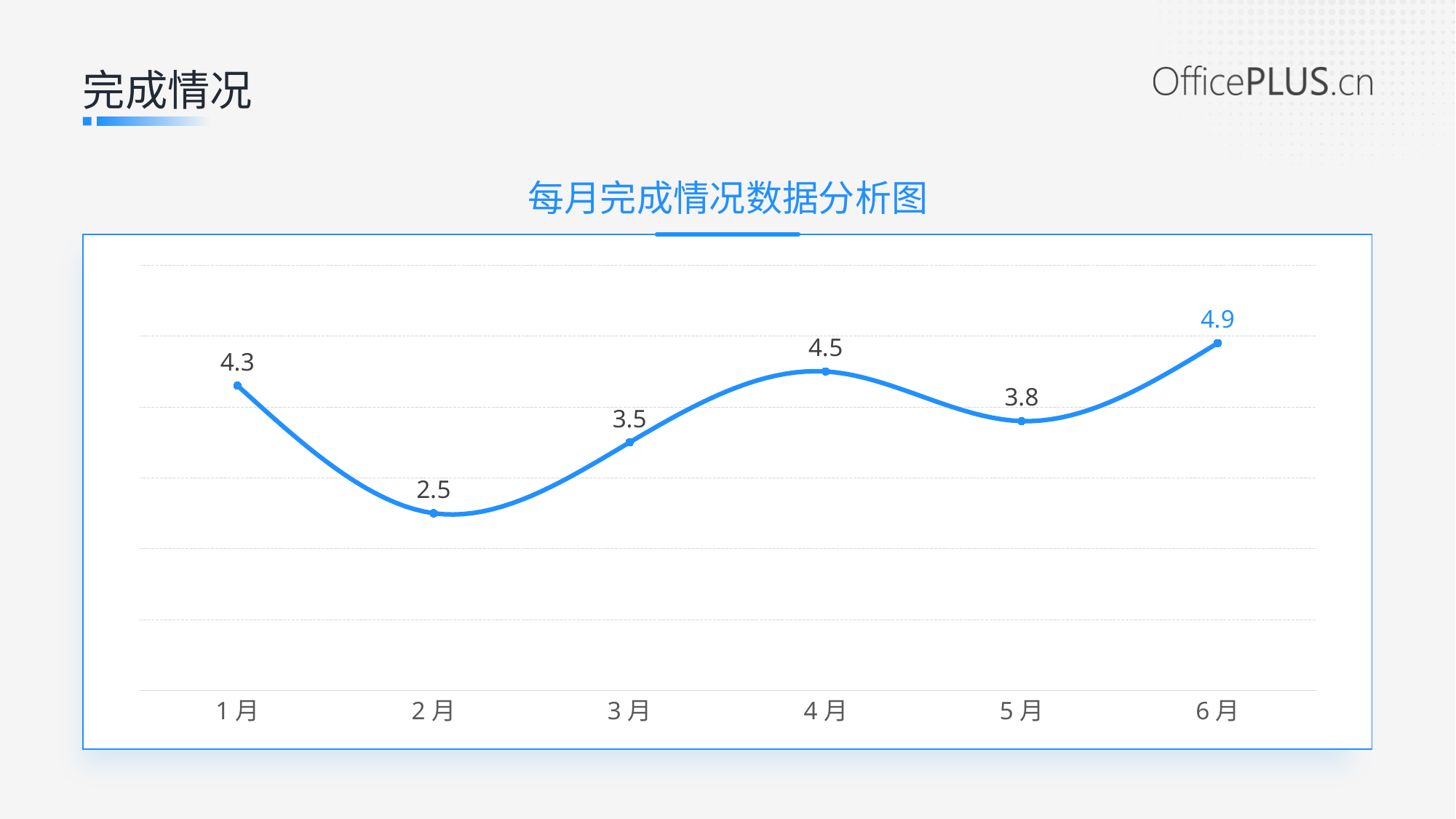
What is the difference between the values for 6月 and 2月? 2.4 Which is larger, the value for 3月 or the value for 5月? 5月 Which month has the lowest value? 2月 What is the value for 2月? 2.5 How many months are plotted on the chart? 6 What is the value for 5月? 3.8 Which month has the highest value? 6月 What is the value for 1月? 4.3 What is the title of the chart? 每月完成情况数据分析图 What kind of chart is shown on the slide? line chart Does the value rise or fall from 1月 to 2月? fall What is the value for 4月? 4.5